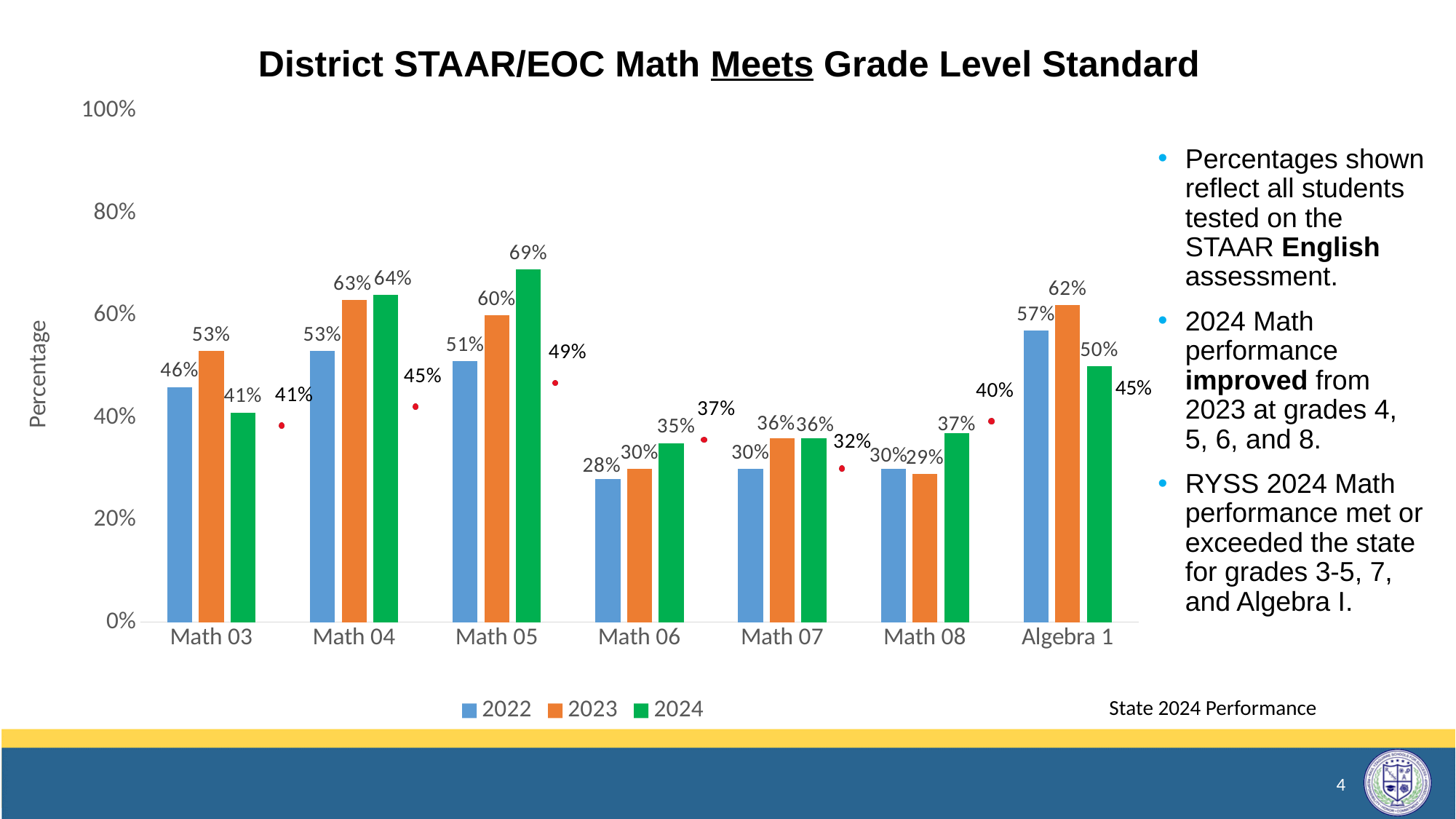
Which category has the highest 2024 value? Math 05 How many grade-level categories are shown on the x axis? 7 How many series does the legend list? 3 What is the 2024 value for Math 05? 69% Which is larger for Math 03: the 2022 value or the 2024 value? 2022 Which category has the lowest 2022 value? Math 06 Do the values for Math 04 rise or fall from 2022 to 2024? Rise What is the 2022 value for Math 06? 28% What is the 2023 value for Algebra 1? 62% What do the red dots on the chart represent? State 2024 Performance What kind of chart is shown on the slide? Bar chart What is the difference between the 2024 and 2023 values for Math 08? 8%